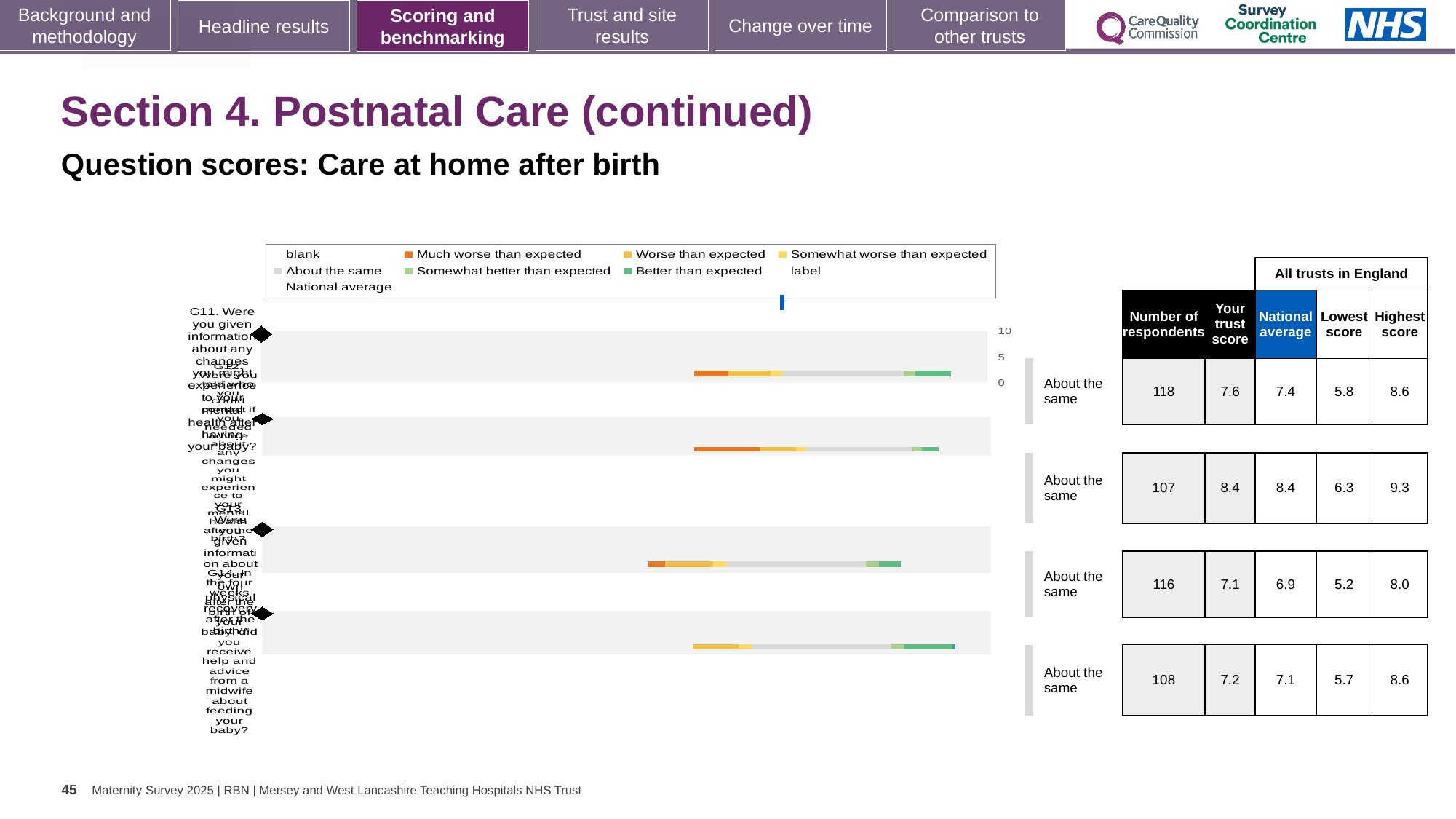
In the table beside the chart, what is the difference between 'Your trust score' and the national average in the first row? 0.2 Which colour does the legend use for 'Better than expected'? green In the table beside the chart, which row has the lowest 'Lowest score'? the third row (5.2) In the table beside the chart, in the third row, which is larger: 'Your trust score' or the national average? Your trust score In the table beside the chart, what is the national average in the fourth row? 7.1 In the table beside the chart, what is the number of respondents in the first row? 118 What comparison label is shown next to each bar in the chart? About the same In the table beside the chart, what is 'Your trust score' in the second row? 8.4 What kind of chart is shown on the slide? bar chart Which colour does the legend use for 'Much worse than expected'? orange How many bars are plotted in the chart? 4 In the table beside the chart, which row has the highest 'Highest score'? the second row (9.3)